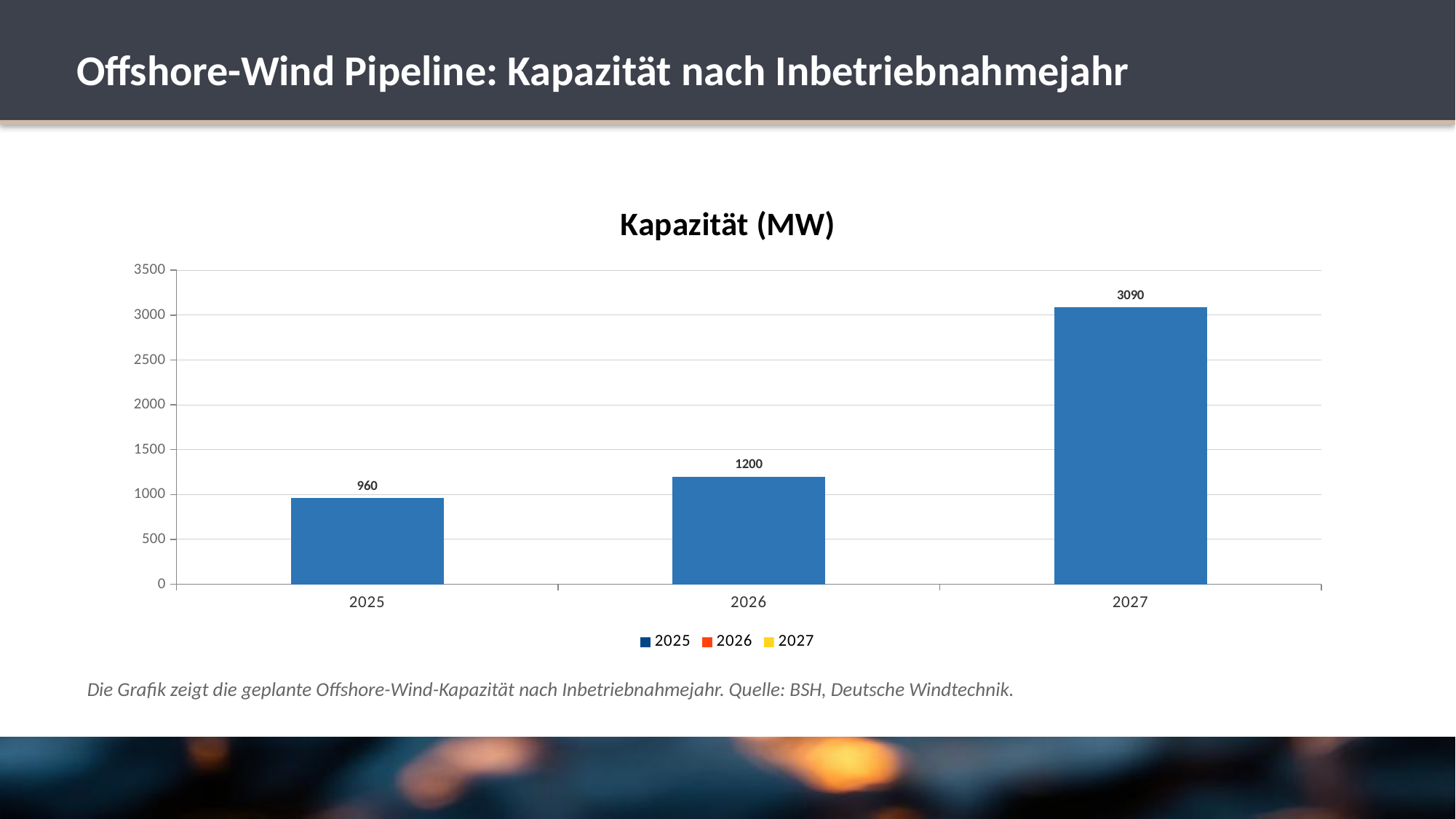
Which is larger, the value for 2025 or the value for 2026? 2026 Do the values rise or fall from 2025 to 2027? rise What is the value for 2025? 960 What is the difference between the values for 2026 and 2025? 240 Which year has the lowest capacity? 2025 What is the value for 2026? 1200 How many years are shown on the x axis? 3 Which year has the highest capacity? 2027 What is the difference between the values for 2027 and 2026? 1890 What is the value for 2027? 3090 Is the value for 2027 greater or less than 3000? greater What kind of chart is shown? bar chart